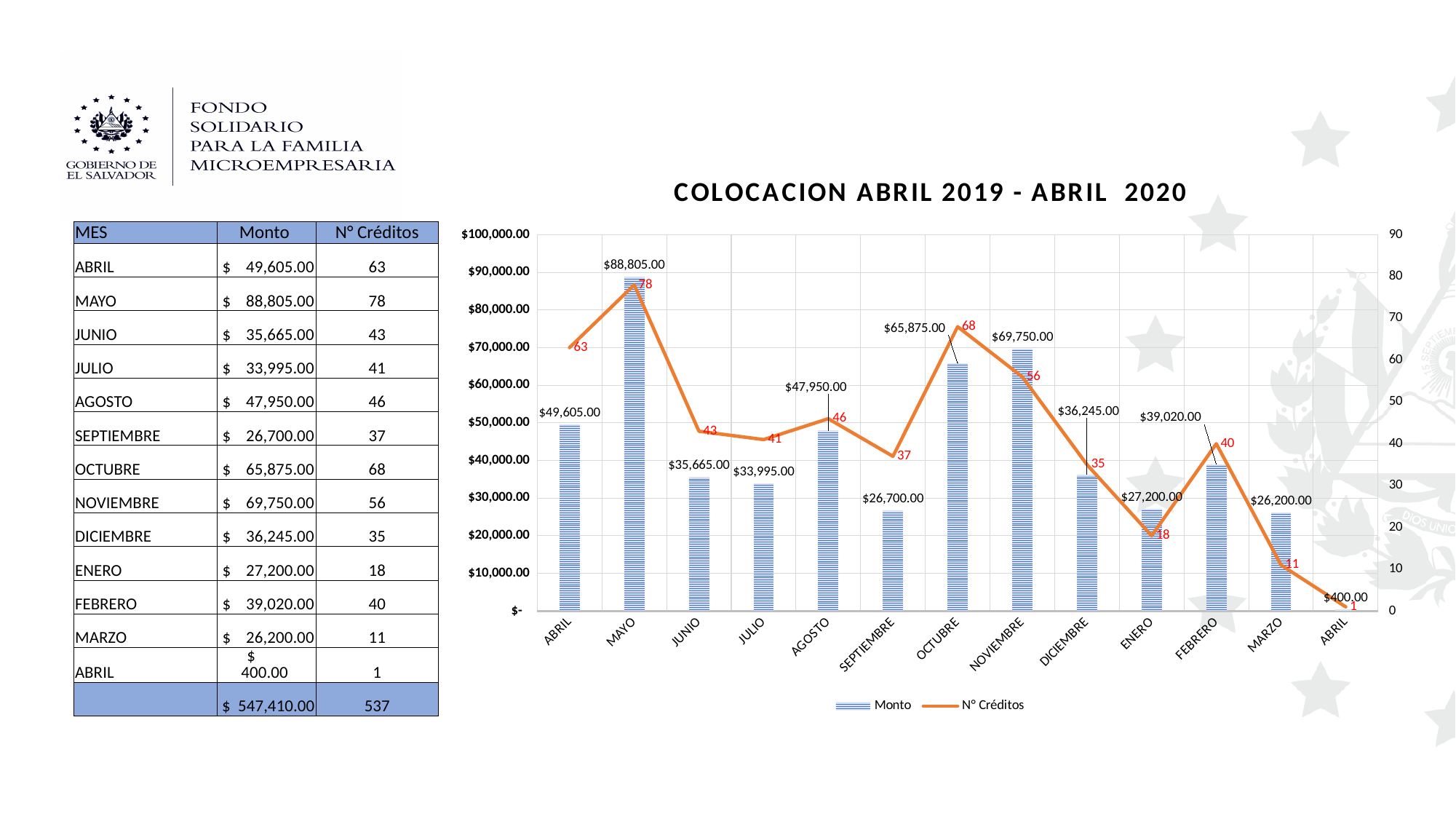
Is the Monto value for DICIEMBRE greater or less than $40,000.00? less Which has a higher Monto, JUNIO or JULIO? JUNIO What is the difference in Monto between NOVIEMBRE and OCTUBRE? $3,875.00 How many months are shown on the x axis? 13 Which month has the lowest N° Créditos? ABRIL (2020) What kind of chart is used for the Monto series? bar chart Which month has the highest Monto? MAYO What is the Monto value for MAYO? $88,805.00 How many series does the legend list? 2 What is the N° Créditos value for OCTUBRE? 68 What is the title of the chart? COLOCACION ABRIL 2019 - ABRIL 2020 Does the N° Créditos line rise or fall from FEBRERO to ABRIL 2020? fall